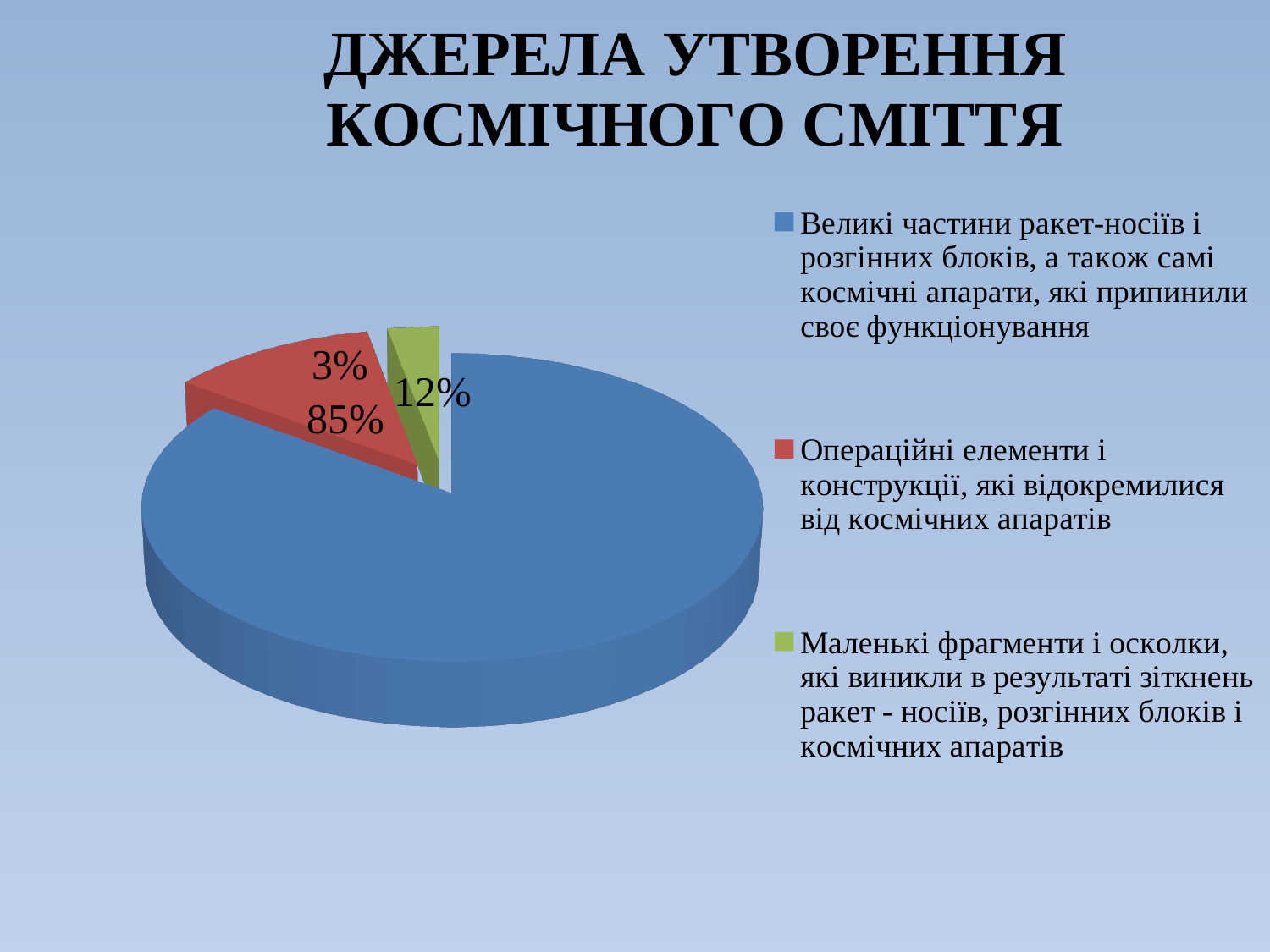
Which slice is larger: the one for operational elements separated from spacecraft, or the one for small fragments from collisions? Операційні елементи і конструкції, які відокремилися від космічних апаратів How many entries does the legend of the pie chart list? 3 What is the title of the slide containing the pie chart? ДЖЕРЕЛА УТВОРЕННЯ КОСМІЧНОГО СМІТТЯ What colour is the slice for small fragments and debris from collisions? Green Which category has the smallest slice of the pie chart? Маленькі фрагменти і осколки, які виникли в результаті зіткнень ракет - носіїв, розгінних блоків і космічних апаратів What share of the pie does the largest slice (large parts of launch vehicles and defunct spacecraft) take? 85% Which category has the largest slice of the pie chart? Великі частини ракет-носіїв і розгінних блоків, а також самі космічні апарати, які припинили своє функціонування What kind of chart is shown on the slide? Pie chart How many slices does the pie chart have? 3 Which slice is larger: the one for large parts of launch vehicles and defunct spacecraft, or the one for operational elements separated from spacecraft? Великі частини ракет-носіїв і розгінних блоків, а також самі космічні апарати, які припинили своє функціонування